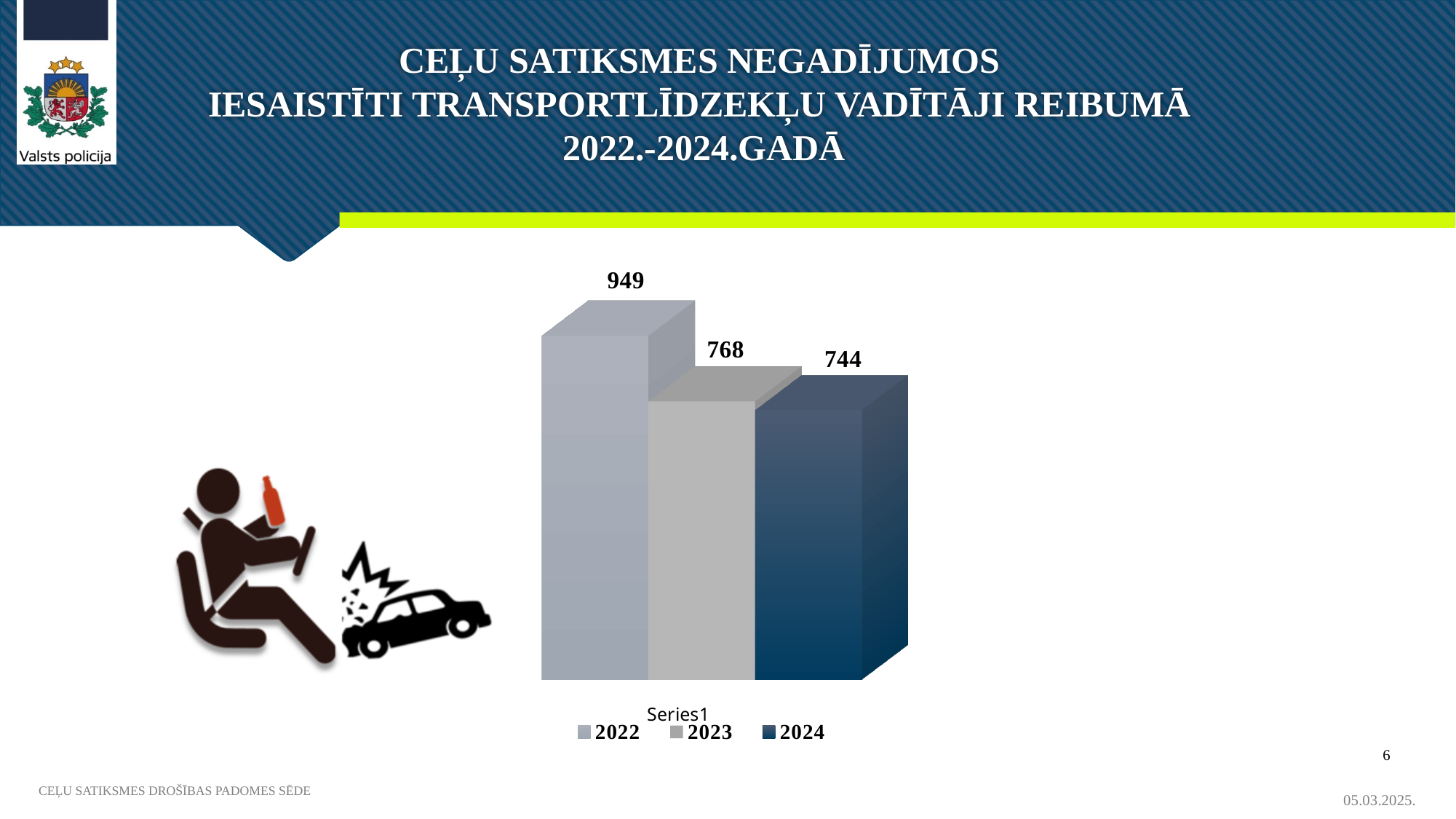
Which is larger, the value for 2022 or the value for 2023? 2022 What is the value for 2023? 768 What is the difference between the values for 2022 and 2024? 205 What is the value for 2022? 949 What kind of chart is shown on the slide? bar chart Which year has the lowest value? 2024 Which year has the highest value? 2022 What is the value for 2024? 744 How many bars are plotted in the chart? 3 Do the values rise or fall from 2022 to 2024? fall How many entries does the legend list? 3 What is the difference between the values for 2023 and 2024? 24